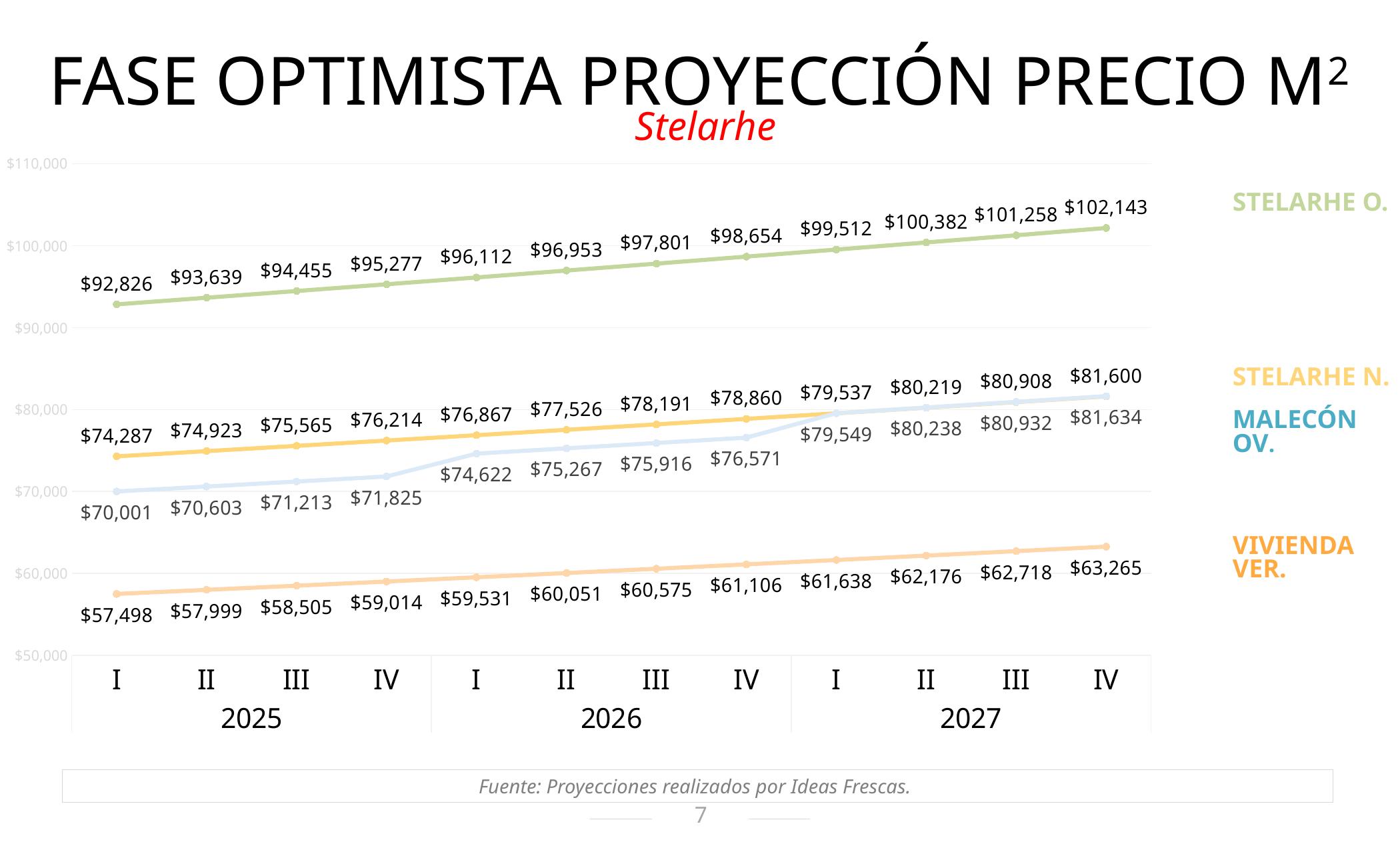
What is the value for STELARHE N. in quarter IV of 2027? $81,600 How many series does the chart show? 4 What is the value for MALECÓN OV. in quarter I of 2025? $70,001 What kind of chart is shown on the slide? Line chart Which is larger in quarter I of 2025: STELARHE N. or MALECÓN OV.? STELARHE N. What is the value for VIVIENDA VER. in quarter IV of 2027? $63,265 Which series has the highest value in quarter IV of 2027? STELARHE O. What is the value for STELARHE O. in quarter I of 2025? $92,826 What is the difference between the STELARHE O. value in quarter IV of 2027 and its value in quarter I of 2025? $9,317 How many quarterly points are plotted along the x axis? 12 Which series has the lowest value in quarter I of 2025? VIVIENDA VER. Do the VIVIENDA VER. values rise or fall from quarter I of 2025 to quarter IV of 2027? Rise